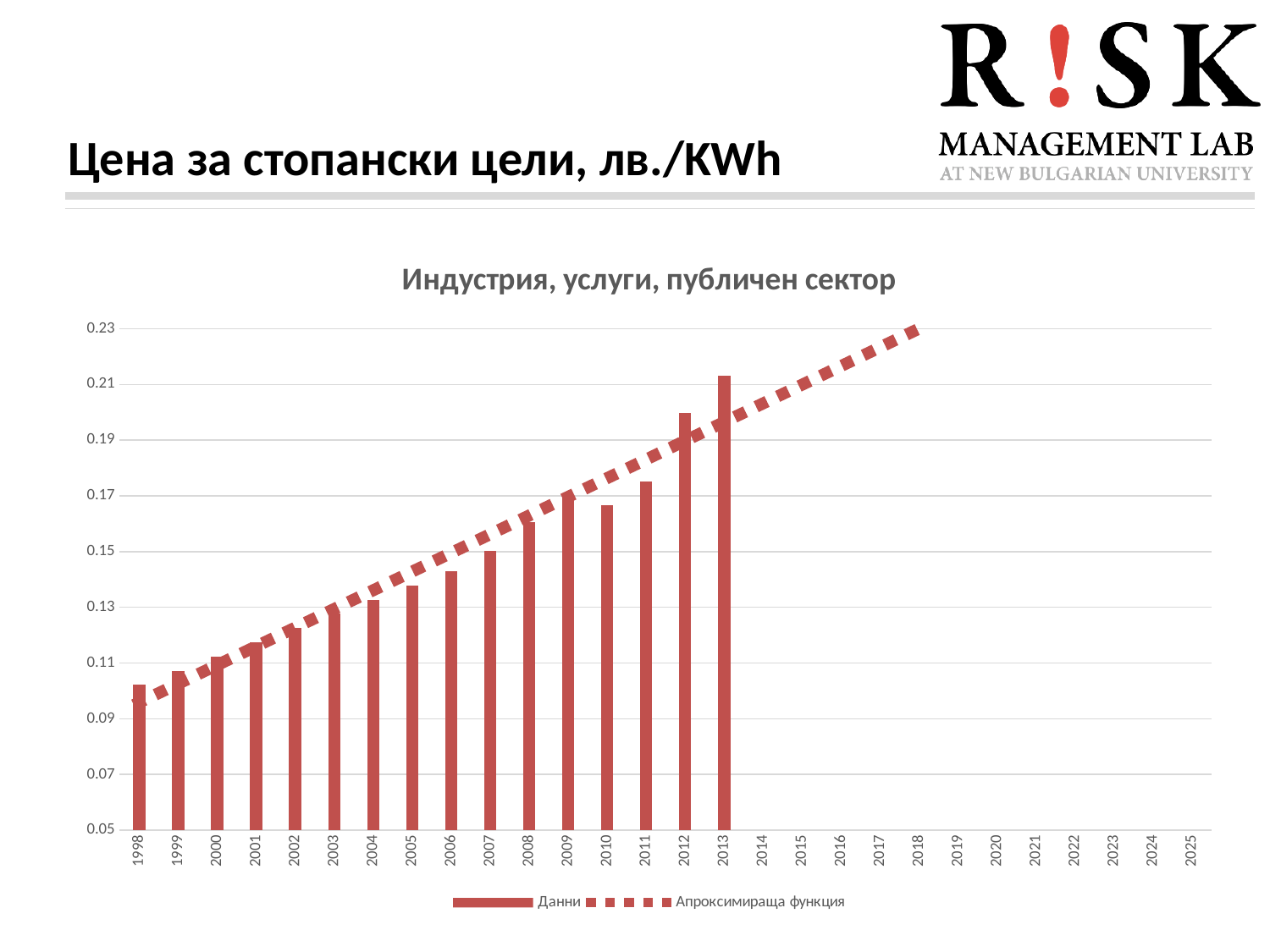
Is the value for 2005 greater or less than 0.13? greater How many series does the legend list? 2 Which year has the lowest bar? 1998 What is the title of the chart? Индустрия, услуги, публичен сектор Do the bar values rise or fall from 1998 to 2013? rise How many years have a bar plotted in the chart? 16 Which year has the highest bar? 2013 Is the value for 1998 greater or less than 0.11? less What kind of chart is shown on the slide? bar chart Is the value for 2013 greater or less than 0.19? greater Which is larger, the value for 2012 or the value for 2011? 2012 What are the two entries in the chart legend? Данни, Апроксимираща функция